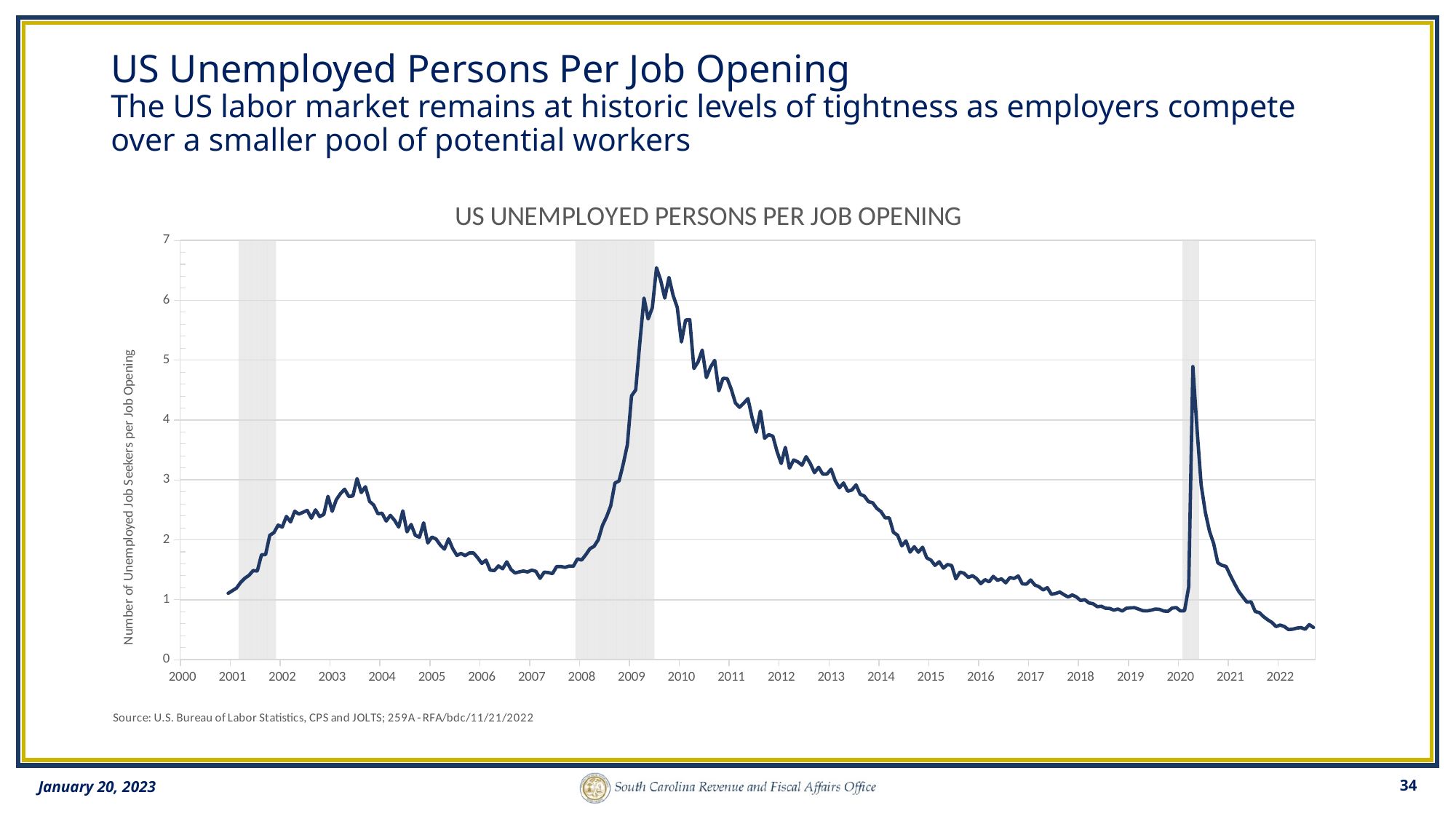
Is the peak value reached in 2009 greater or less than 6? greater Is the spike value in 2020 greater or less than 4? greater Is the peak value reached in 2003 greater or less than 2? greater Do the values generally rise or fall between 2001 and 2003? rise What is the title of the chart? US UNEMPLOYED PERSONS PER JOB OPENING Which is higher, the peak in 2009 or the spike in 2020? the peak in 2009 In which year does the series reach its highest value? 2009 What type of chart is shown on the slide? line chart Do the values generally rise or fall between 2010 and 2019? fall How many shaded vertical bands appear on the chart? 3